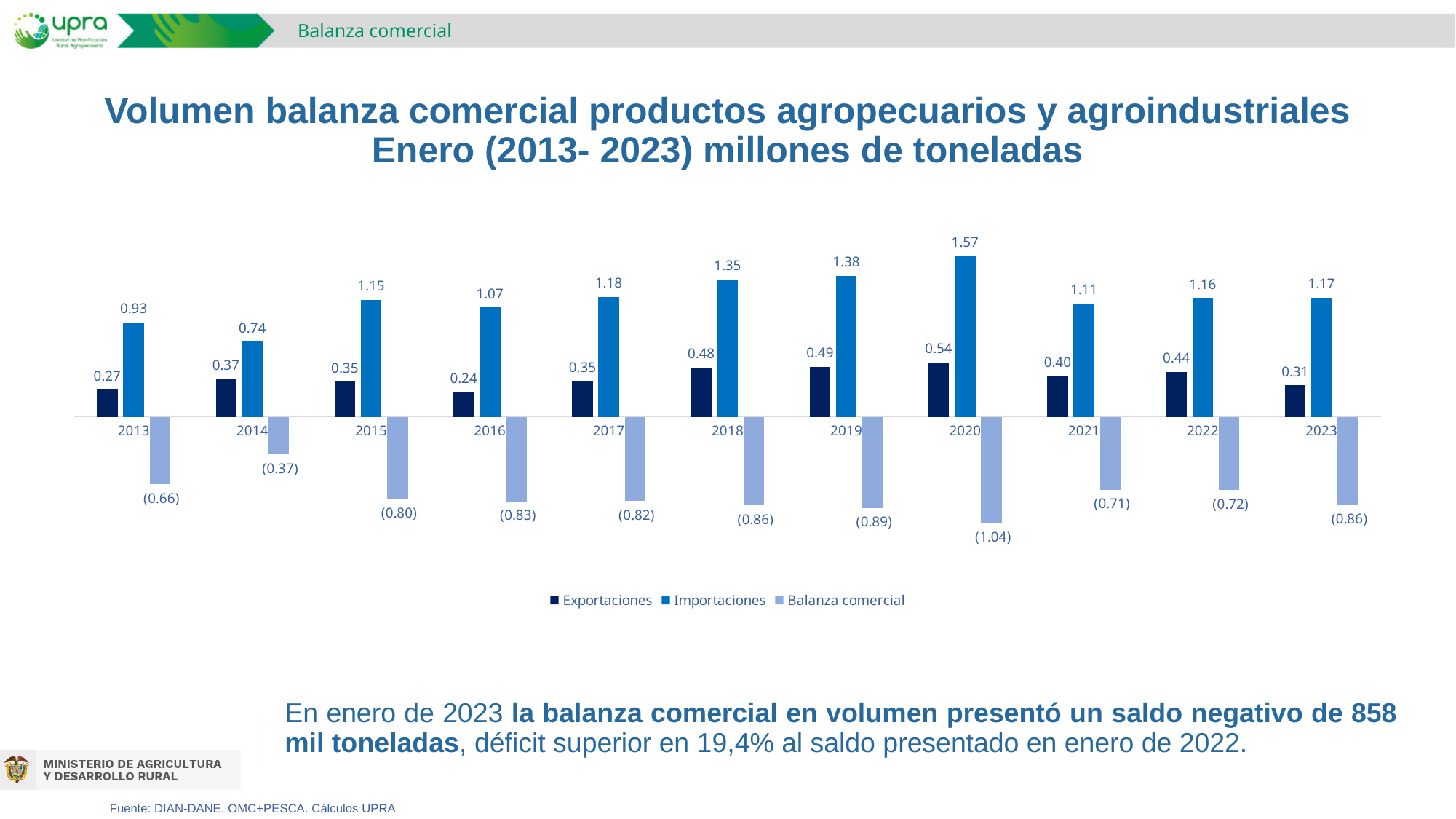
What is the value of Balanza comercial for 2023? (0.86) Do the Importaciones values rise or fall from 2013 to 2020? Rise Which year has the lowest Exportaciones value? 2016 How many series does the legend list? 3 Which is larger, Exportaciones in 2019 or Exportaciones in 2021? Exportaciones in 2019 Which series is shown in light blue in the legend? Balanza comercial What kind of chart is shown on the slide? Bar chart How many years are shown on the x axis? 11 What is the value of Importaciones for 2020? 1.57 What is the value of Exportaciones for 2016? 0.24 What is the difference between Importaciones and Exportaciones in 2023? 0.86 Which year has the highest Importaciones value? 2020